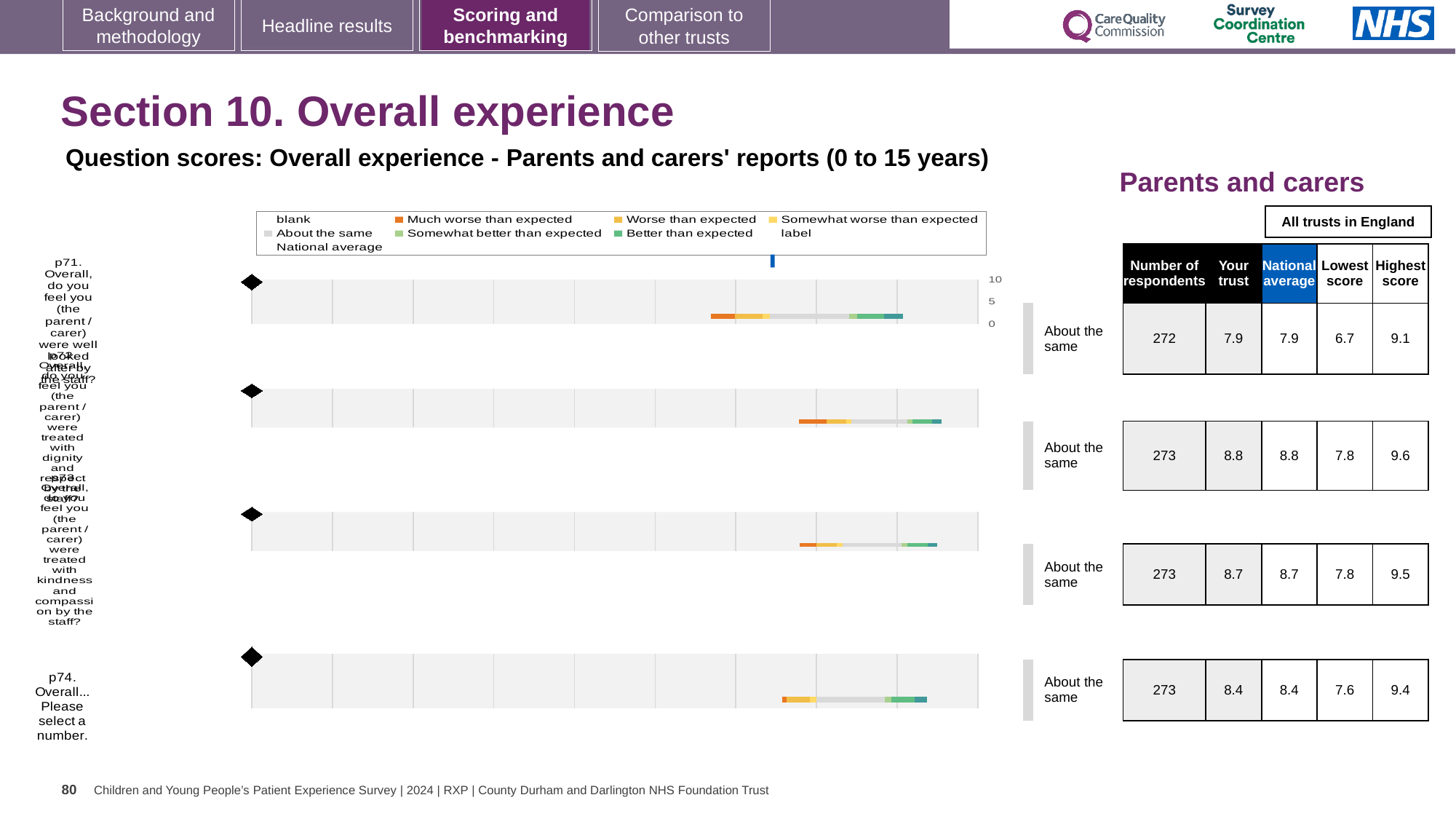
How many question rows (bars) are plotted in the chart? 4 What is the 'Your trust' score for p71 (Overall, do you feel you were well looked after by the staff?)? 7.9 What is the difference between the highest score and the lowest score for p71? 2.4 What is the national average for the second question row in the chart? 8.8 What is the highest score across all trusts in England for p74? 9.4 What benchmark category is shown for p74? About the same What is the 'Your trust' score for p74 (Overall... Please select a number)? 8.4 What colour does the legend use for 'Much worse than expected'? orange Which has the larger 'Your trust' score, p71 or p74? p74 What is the number of respondents for p71? 272 Which question row has the lowest 'Lowest score' value? p71 What kind of chart is used to show the question scores on this slide? bar chart